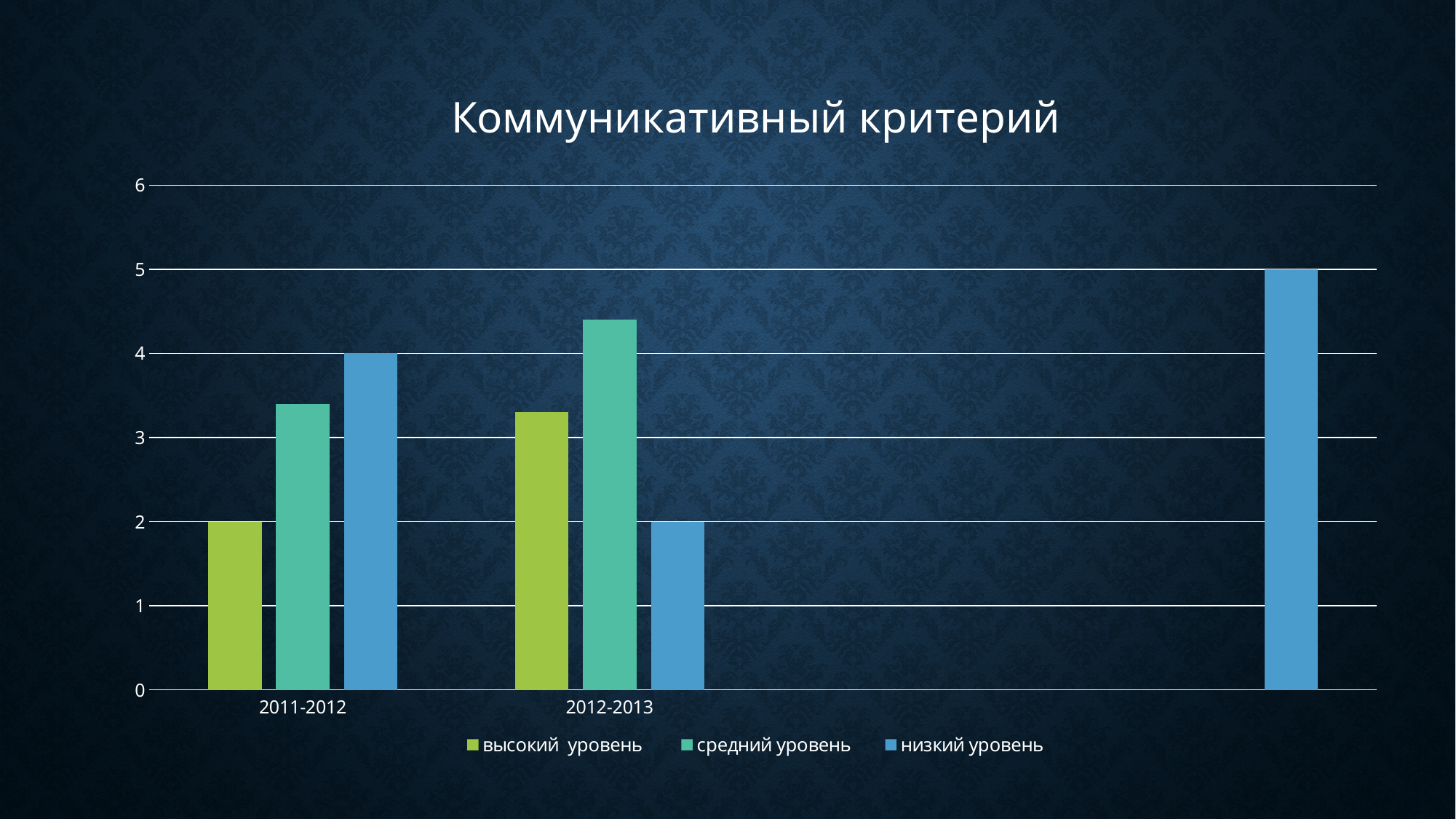
Is the value for средний уровень in 2012-2013 greater or less than 4? greater Which series has the highest value in 2012-2013? средний уровень What kind of chart is shown on the slide? bar chart Which series has the highest value in 2011-2012? низкий уровень What is the value for высокий уровень in 2011-2012? 2 How many series does the legend list? 3 By how much does низкий уровень in 2011-2012 exceed низкий уровень in 2012-2013? 2 What is the title of the chart? Коммуникативный критерий Is the value for средний уровень in 2011-2012 greater or less than 3? greater What is the value for низкий уровень in 2012-2013? 2 What is the value for низкий уровень in 2011-2012? 4 Which is larger for высокий уровень: 2011-2012 or 2012-2013? 2012-2013